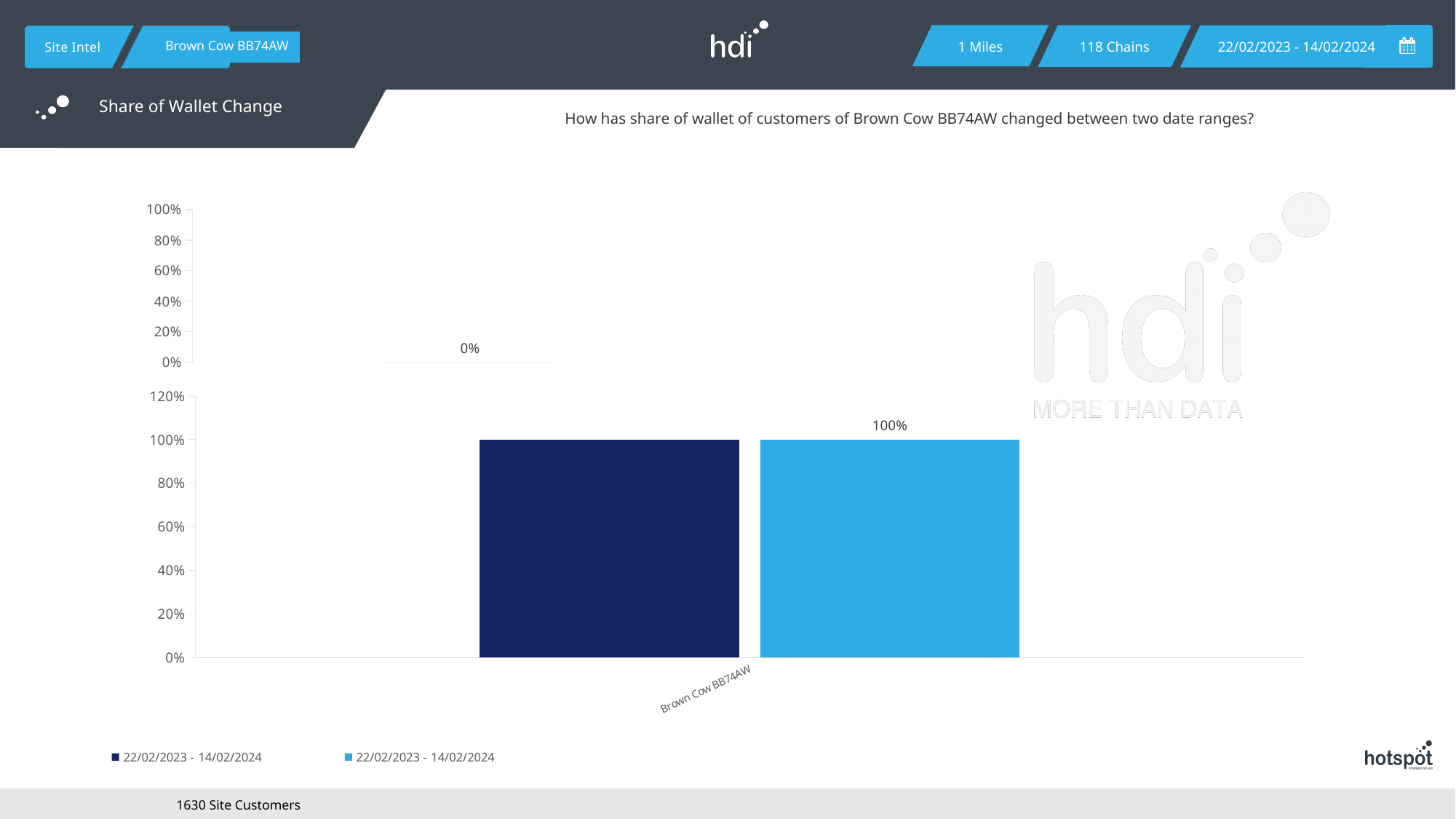
What is the category label shown on the x axis of the lower chart? Brown Cow BB74AW In the lower chart, is the value of the dark blue bar for Brown Cow BB74AW greater or less than 80%? greater In the lower chart, how many categories are shown on the x axis? 1 How many series does the legend at the bottom of the slide list? 2 In the upper chart, what value is printed as the data label? 0% What date range is shown for the light blue series in the legend? 22/02/2023 - 14/02/2024 In the lower chart, is the value of the dark blue bar for Brown Cow BB74AW greater or less than 20%? greater In the lower chart, is the value of the light blue bar for Brown Cow BB74AW greater or less than 120%? less What kind of chart is the lower chart on the slide? bar chart In the lower chart, what value is printed above the light blue bar for Brown Cow BB74AW? 100%